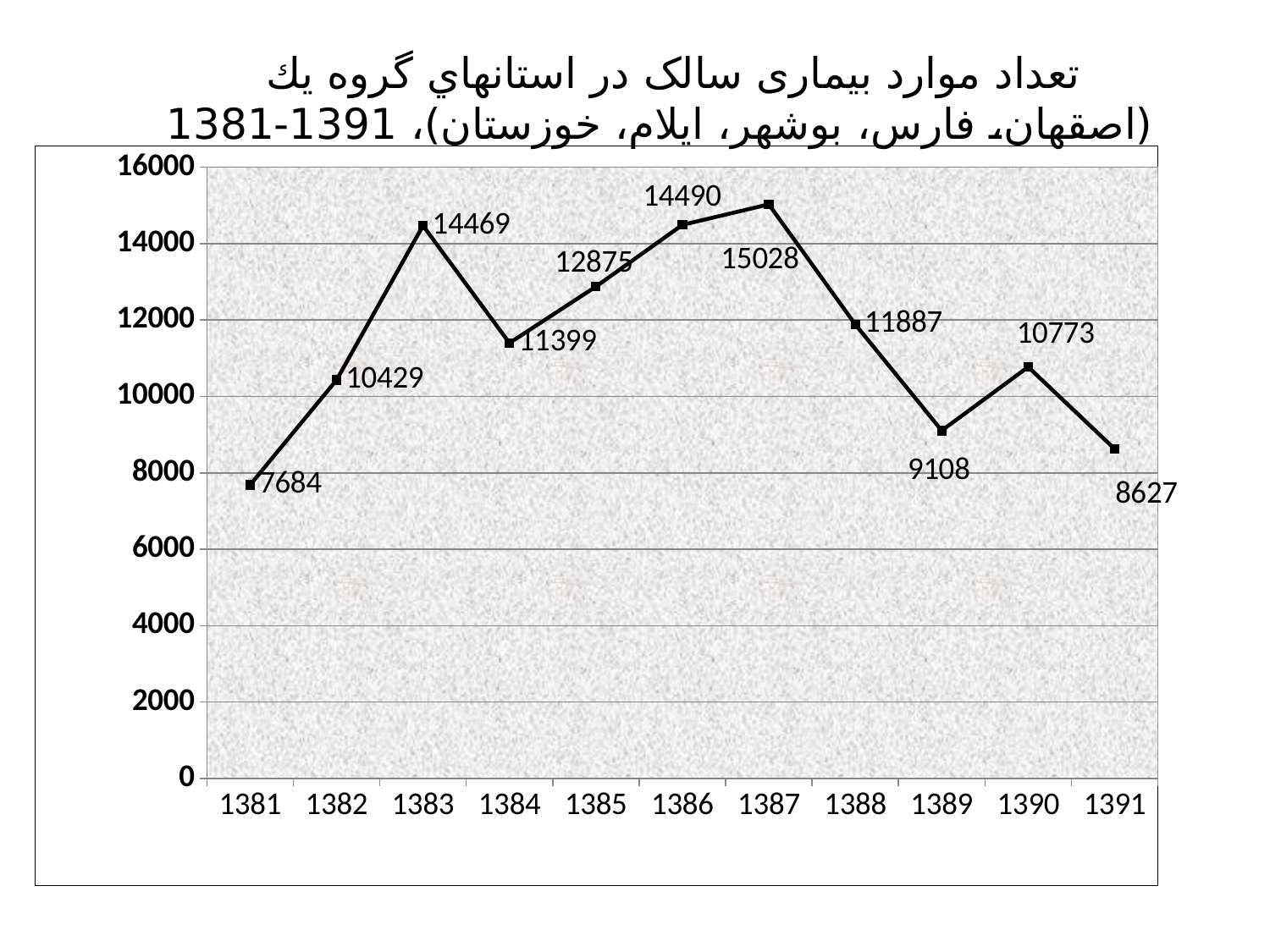
Which year has the lowest value? 1381 How many years are plotted on the x axis? 11 What is the difference between the values for 1387 and 1381? 7344 What is the value for 1383? 14469 Is the value for 1390 greater or less than 12000? less Which is larger, the value for 1385 or the value for 1388? 1385 Which year has the highest value? 1387 What is the value for 1391? 8627 What is the value for 1389? 9108 What kind of chart is shown on the slide? line chart What is the difference between the values for 1383 and 1384? 3070 Do the values rise or fall from 1387 to 1389? fall